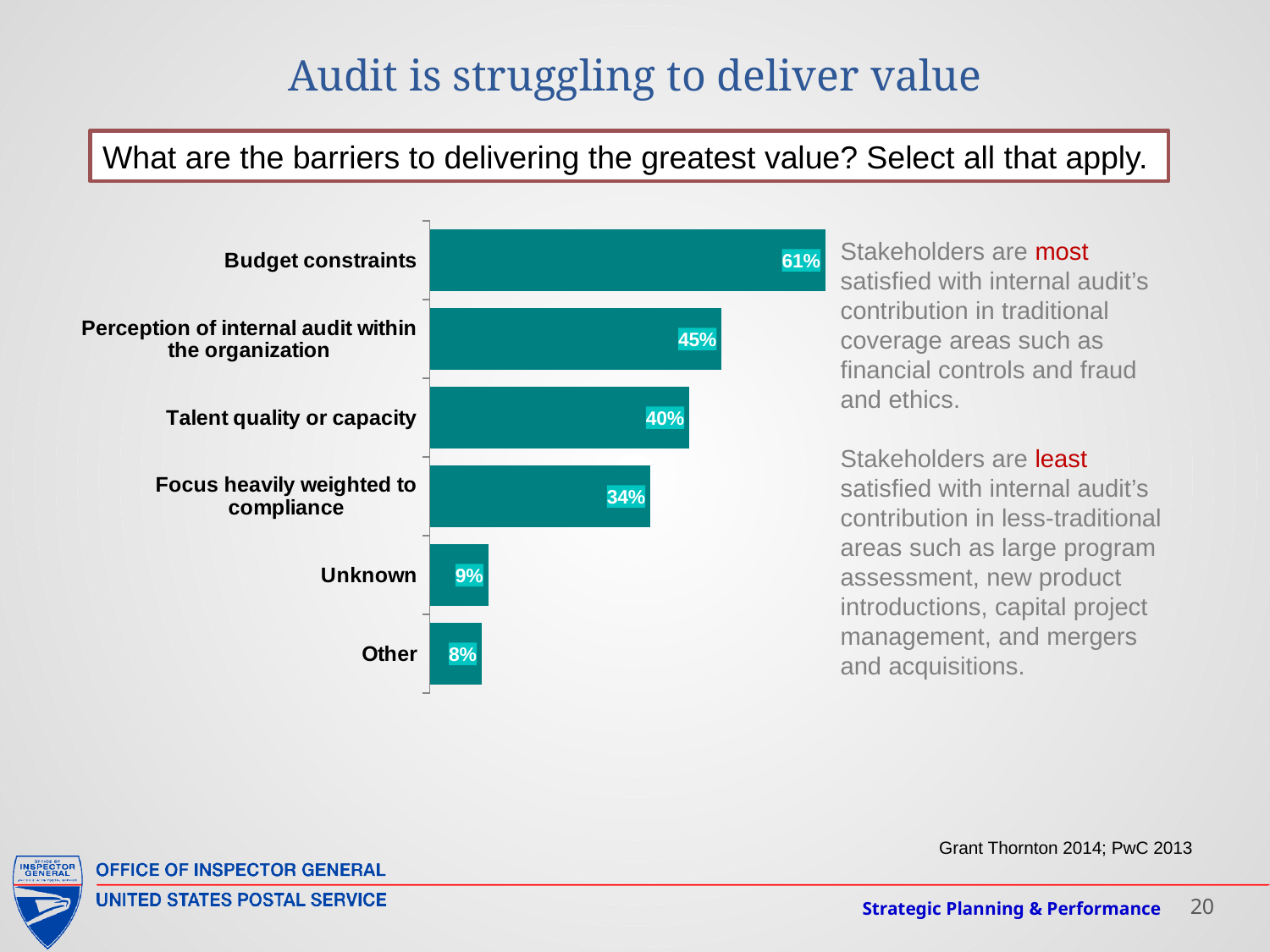
What is the value for Talent quality or capacity? 40% How many categories are shown in the chart? 6 What is the difference between Budget constraints and Perception of internal audit within the organization? 16% What question does the chart answer, as shown in the box above it? What are the barriers to delivering the greatest value? Select all that apply. Which category has the lowest percentage? Other Which is larger: Talent quality or capacity, or Focus heavily weighted to compliance? Talent quality or capacity Which barrier has the highest percentage? Budget constraints What is the difference between Unknown and Other? 1% What type of chart is shown on the slide? Bar chart What percentage of respondents selected Budget constraints as a barrier? 61% What is the value for Perception of internal audit within the organization? 45% What is the value for Focus heavily weighted to compliance? 34%